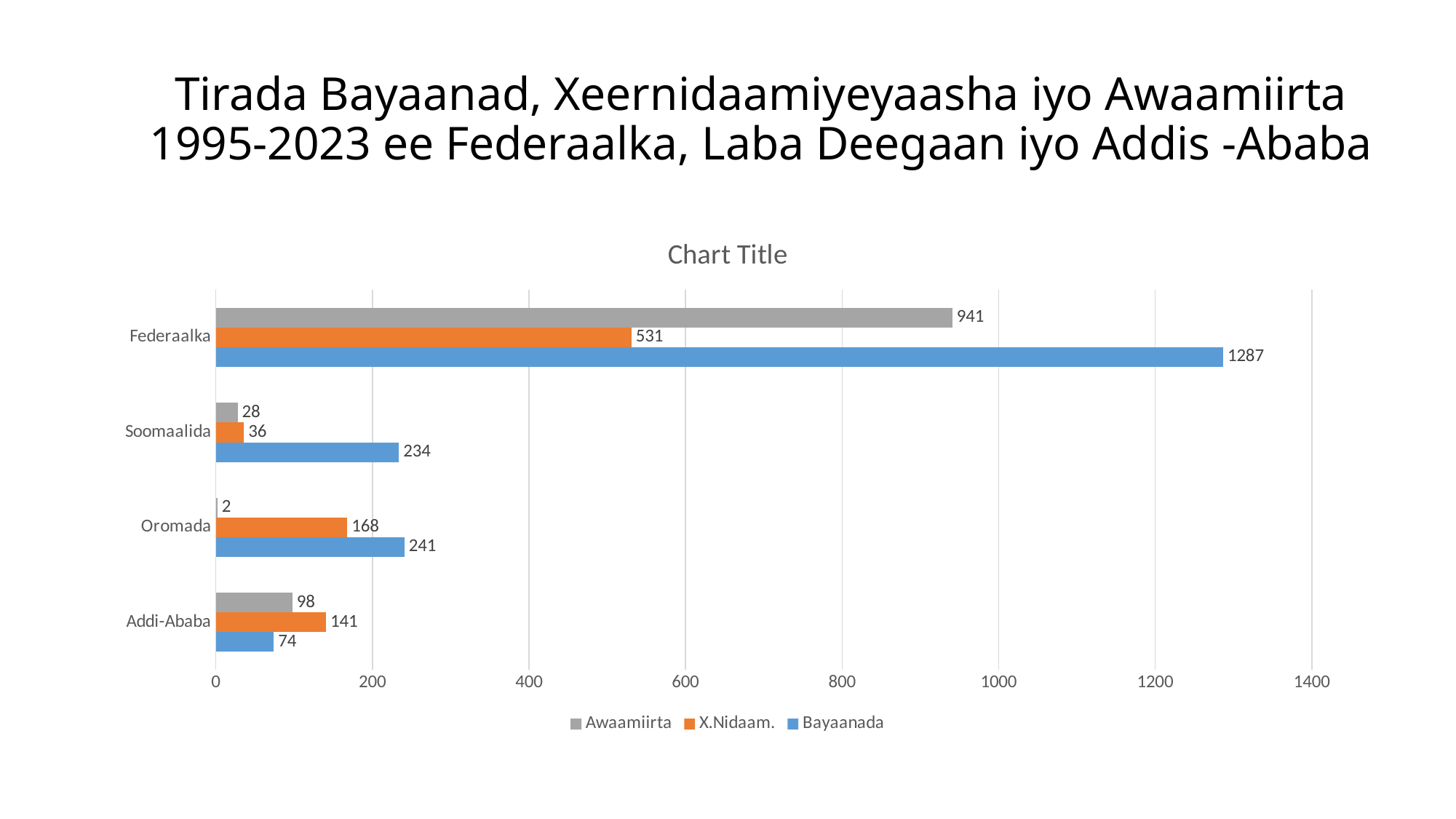
What kind of chart is shown on the slide? Bar chart Which category has the highest Bayaanada value? Federaalka What is the Bayaanada value for Federaalka? 1287 Which category has the lowest Awaamiirta value? Oromada Which colour represents the Bayaanada series? Blue What is the Awaamiirta value for Addi-Ababa? 98 How many categories are shown on the y axis? 4 What is the difference between the Bayaanada and X.Nidaam. values for Federaalka? 756 Is the Awaamiirta value for Federaalka greater or less than 800? greater What is the X.Nidaam. value for Oromada? 168 How many series does the legend list? 3 Which is larger for Addi-Ababa, the X.Nidaam. value or the Bayaanada value? X.Nidaam.